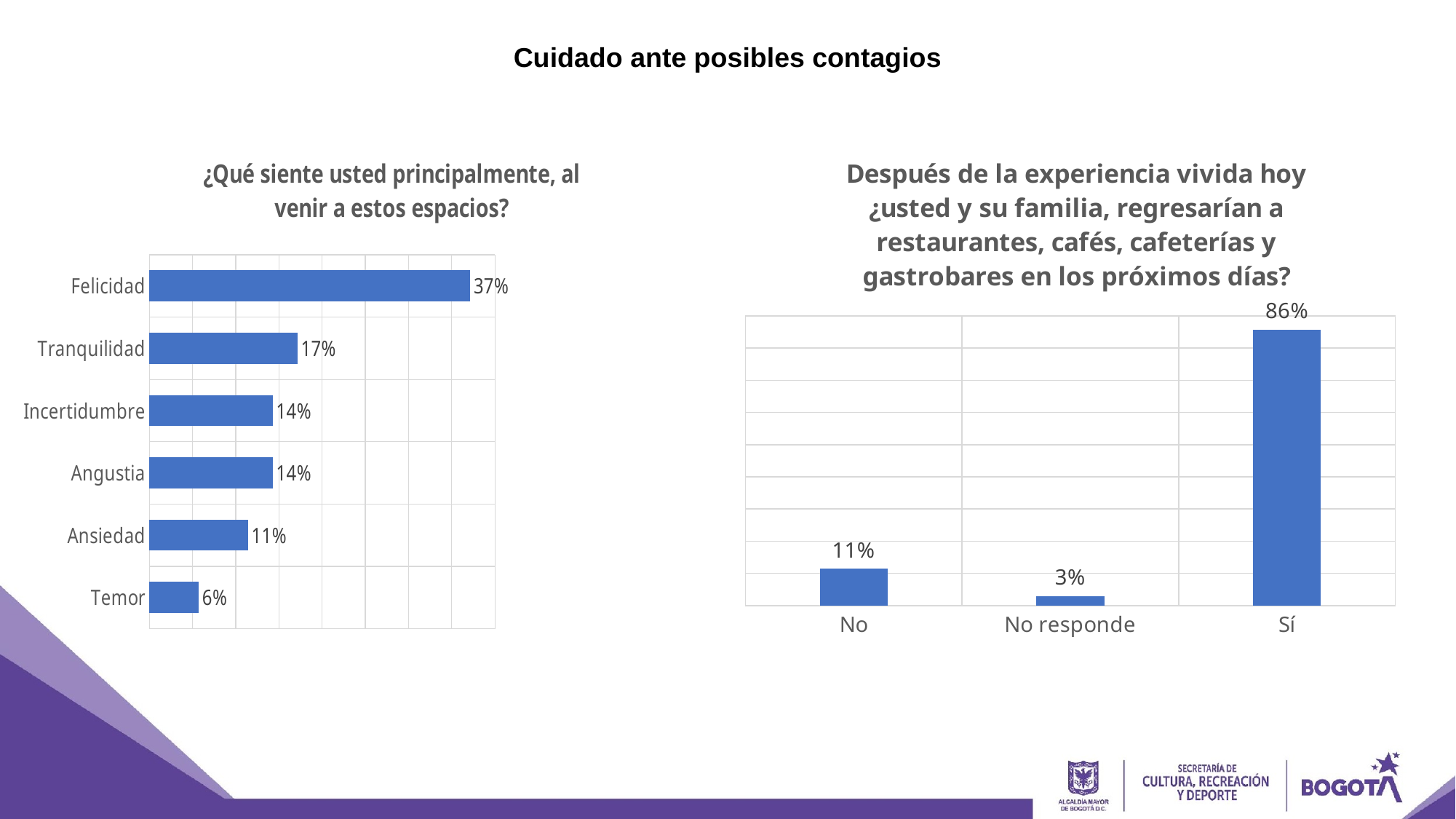
In the left chart '¿Qué siente usted principalmente, al venir a estos espacios?', which is larger, Ansiedad or Temor? Ansiedad In the left chart '¿Qué siente usted principalmente, al venir a estos espacios?', what is the value for Felicidad? 37% In the right chart about returning to restaurantes, cafés, cafeterías y gastrobares, what is the difference between Sí and No? 75% In the right chart about returning to restaurantes, cafés, cafeterías y gastrobares, what is the value for No responde? 3% In the left chart '¿Qué siente usted principalmente, al venir a estos espacios?', which category has the highest value? Felicidad In the right chart about returning to restaurantes, cafés, cafeterías y gastrobares, how many categories are shown? 3 In the left chart '¿Qué siente usted principalmente, al venir a estos espacios?', what is the difference between Felicidad and Tranquilidad? 20% In the left chart '¿Qué siente usted principalmente, al venir a estos espacios?', what is the value for Tranquilidad? 17% In the left chart '¿Qué siente usted principalmente, al venir a estos espacios?', how many categories are shown? 6 In the right chart about returning to restaurantes, cafés, cafeterías y gastrobares, what is the value for Sí? 86% What type of chart is the left chart '¿Qué siente usted principalmente, al venir a estos espacios?'? Bar chart In the left chart '¿Qué siente usted principalmente, al venir a estos espacios?', which category has the lowest value? Temor